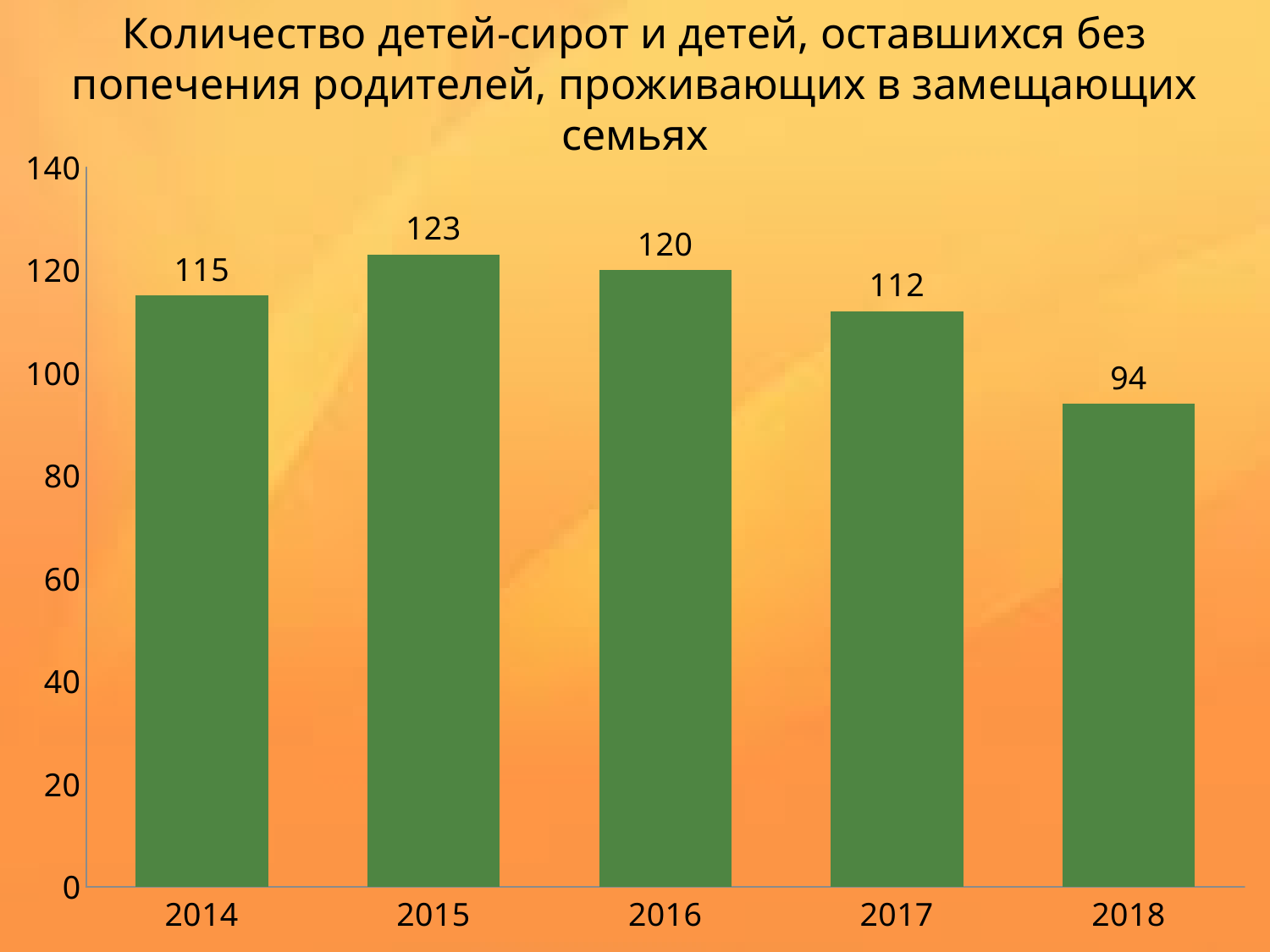
What is the value for 2018? 94 Which year has the lowest value? 2018 What kind of chart is this? bar chart What is the value for 2016? 120 Is the value for 2018 greater or less than 100? less Which is larger, the value for 2014 or the value for 2017? 2014 How many years are shown on the x axis? 5 What is the difference between the values for 2015 and 2018? 29 Do the values rise or fall from 2015 to 2018? fall Which year has the highest value? 2015 What is the value for 2014? 115 What is the difference between the values for 2016 and 2017? 8